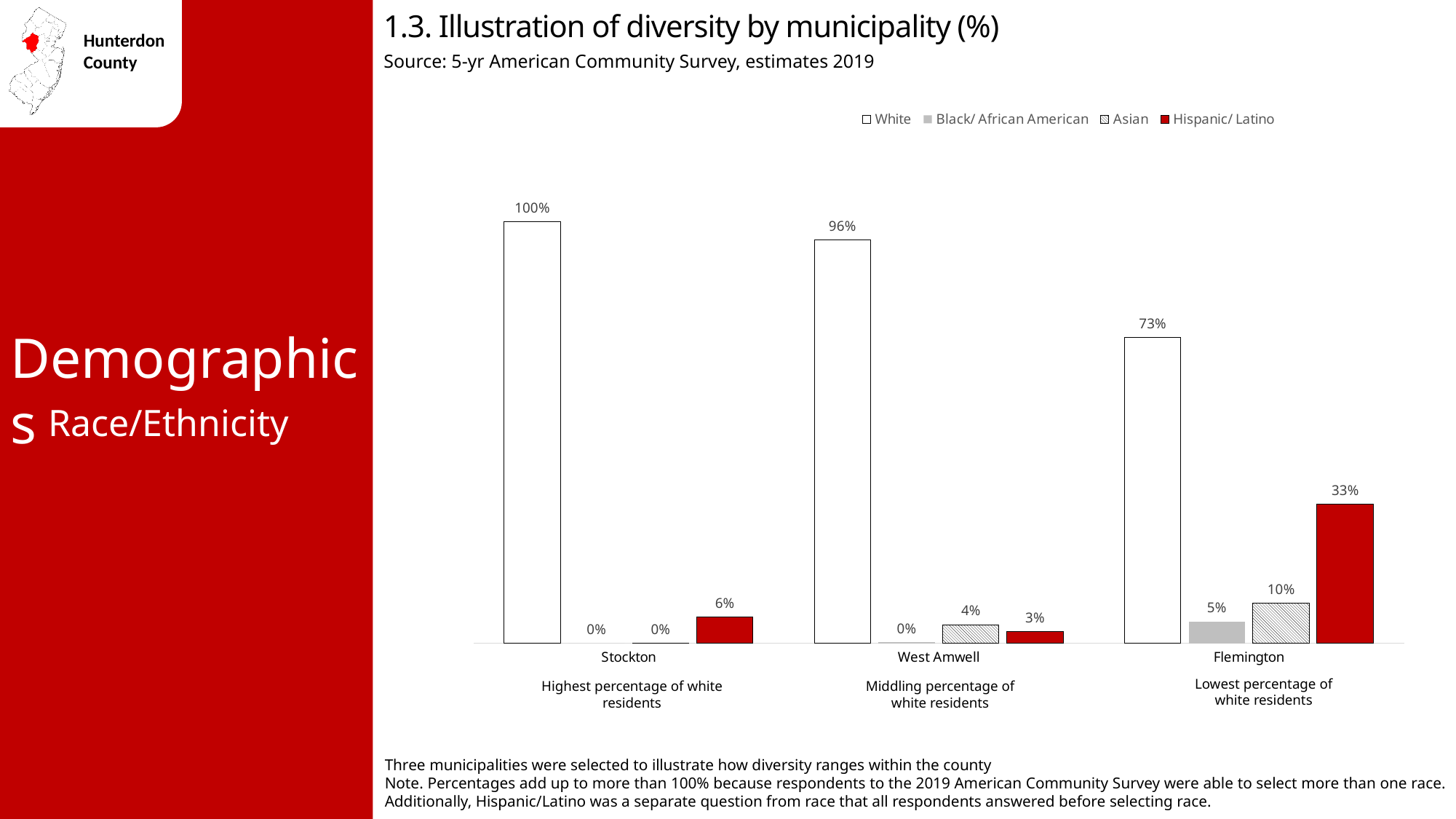
Which municipality has the highest value for Hispanic/ Latino? Flemington What is the title of the chart? 1.3. Illustration of diversity by municipality (%) What kind of chart is shown? Bar chart What is the value for Asian in West Amwell? 4% How many municipalities are shown on the x axis? 3 What is the value for Hispanic/ Latino in Flemington? 33% What is the difference between the White values for Stockton and Flemington? 27% How many series does the legend list? 4 Which is larger, the Asian value in Flemington or the Hispanic/ Latino value in Stockton? Asian value in Flemington What is the value for White in Stockton? 100% What is the value for Black/ African American in Flemington? 5% Which municipality has the lowest value for White? Flemington